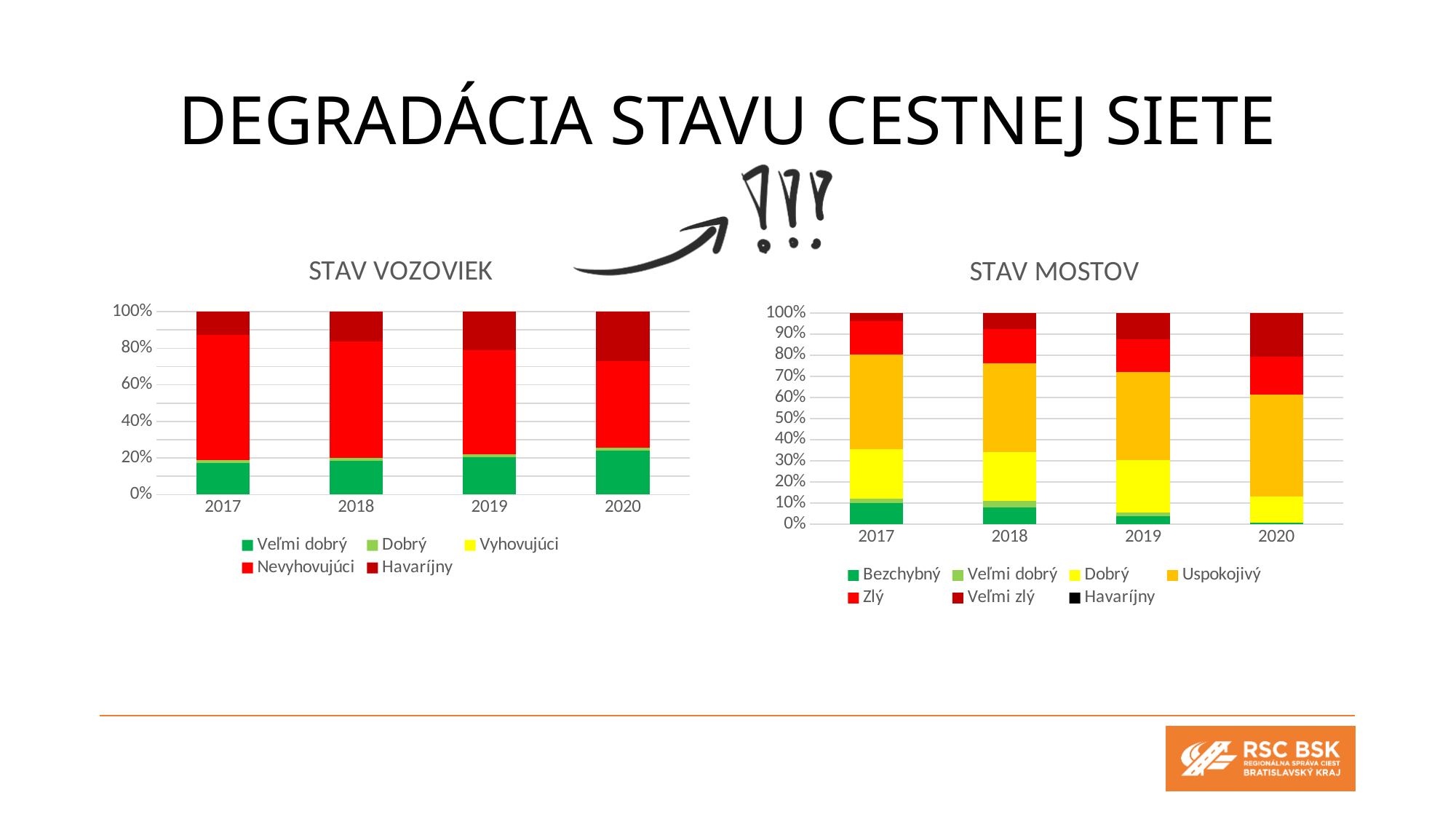
How many series does the legend of the STAV VOZOVIEK chart list? 5 In the STAV VOZOVIEK chart, does the Havaríjny share rise or fall from 2017 to 2020? rise What kind of chart is the STAV VOZOVIEK chart? stacked bar chart How many years are shown on the x axis of the STAV MOSTOV chart? 4 In the STAV MOSTOV chart, does the Dobrý share rise or fall from 2017 to 2020? fall In the STAV VOZOVIEK chart, which colour represents the Nevyhovujúci series? red In the STAV MOSTOV chart, is the Uspokojivý share for 2020 greater or less than 40%? greater In the STAV VOZOVIEK chart, is the Veľmi dobrý share for 2020 greater or less than 20%? greater How many series does the legend of the STAV MOSTOV chart list? 7 What is the title of the chart on the right side of the slide? STAV MOSTOV In the STAV MOSTOV chart, is the Bezchybný share for 2017 greater or less than 20%? less